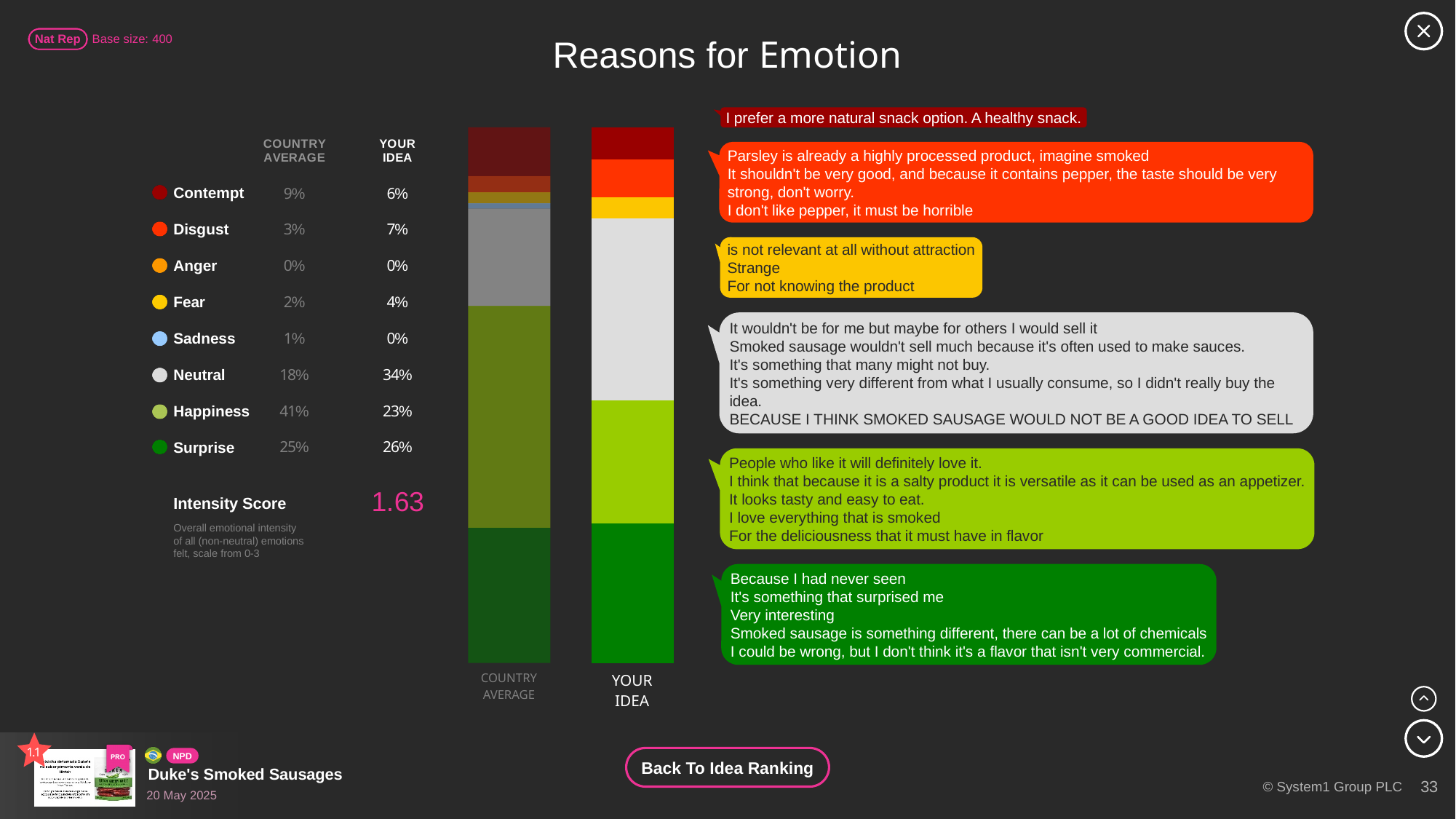
What is the difference between the Neutral values for Your Idea and the Country Average? 16% How many emotion categories are listed in the chart? 8 What is the difference between the Happiness values for the Country Average and Your Idea? 18% What kind of chart is shown on the slide? Stacked bar chart Which emotion has the highest value for Your Idea? Neutral What is the Neutral value for Your Idea? 34% What is the Happiness value for the Country Average? 41% What is the Surprise value for Your Idea? 26% Which emotion has the highest value for the Country Average? Happiness What is the Disgust value for the Country Average? 3% What is the Intensity Score shown on the slide? 1.63 Which is larger, the Contempt value for the Country Average or for Your Idea? Country Average